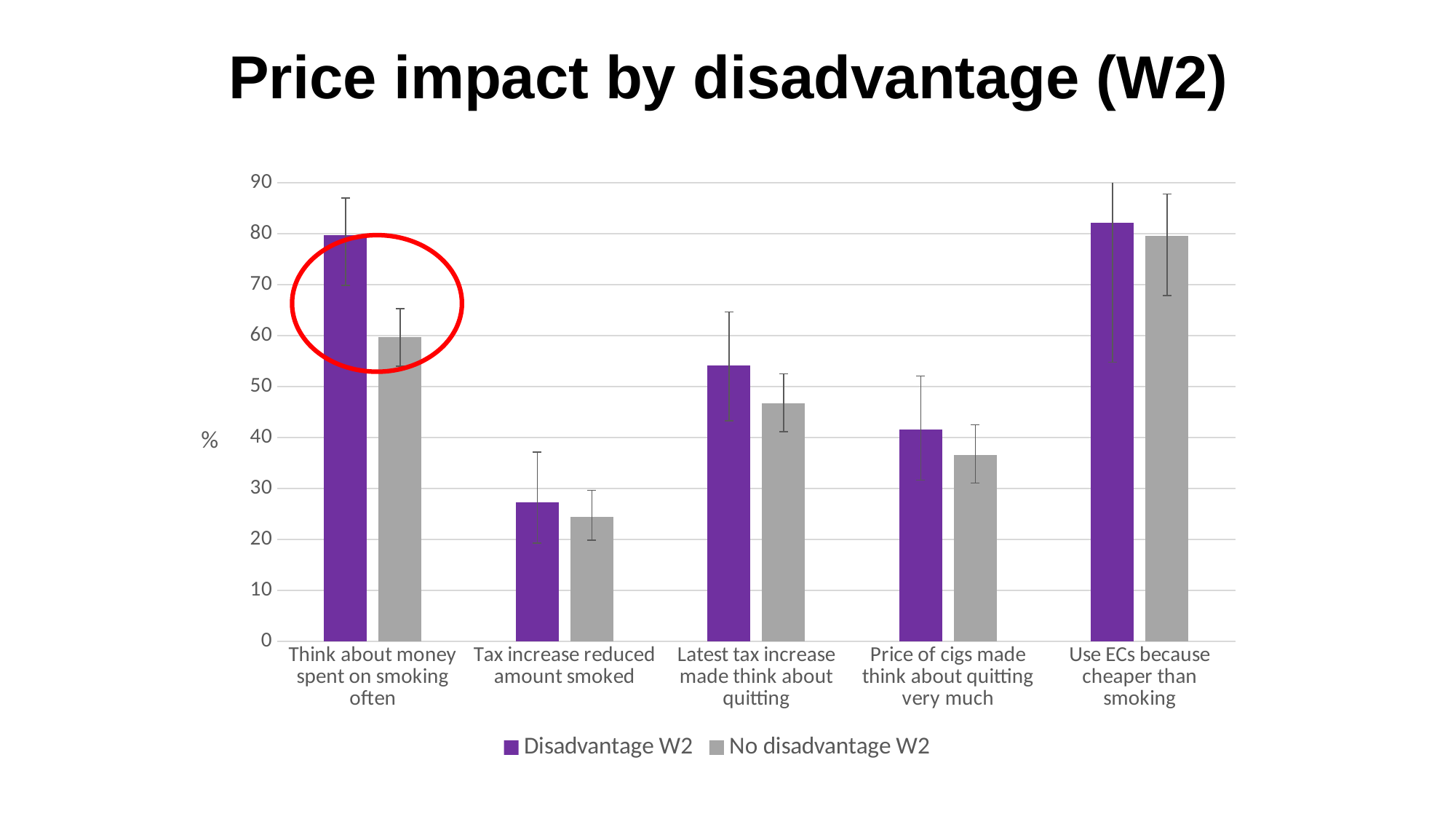
How many categories are shown on the x axis? 5 Is the No disadvantage W2 value for 'Price of cigs made think about quitting very much' greater or less than 40? less For 'Latest tax increase made think about quitting', which series has the larger value, Disadvantage W2 or No disadvantage W2? Disadvantage W2 Which category has the highest value for the No disadvantage W2 series? Use ECs because cheaper than smoking What is the title of the chart on the slide? Price impact by disadvantage (W2) Which category has the lowest value for the Disadvantage W2 series? Tax increase reduced amount smoked What kind of chart is shown on the slide? bar chart Is the Disadvantage W2 value for 'Tax increase reduced amount smoked' greater or less than 30? less For 'Think about money spent on smoking often', which series has the larger value, Disadvantage W2 or No disadvantage W2? Disadvantage W2 Is the No disadvantage W2 value for 'Think about money spent on smoking often' greater or less than 70? less How many series does the legend list? 2